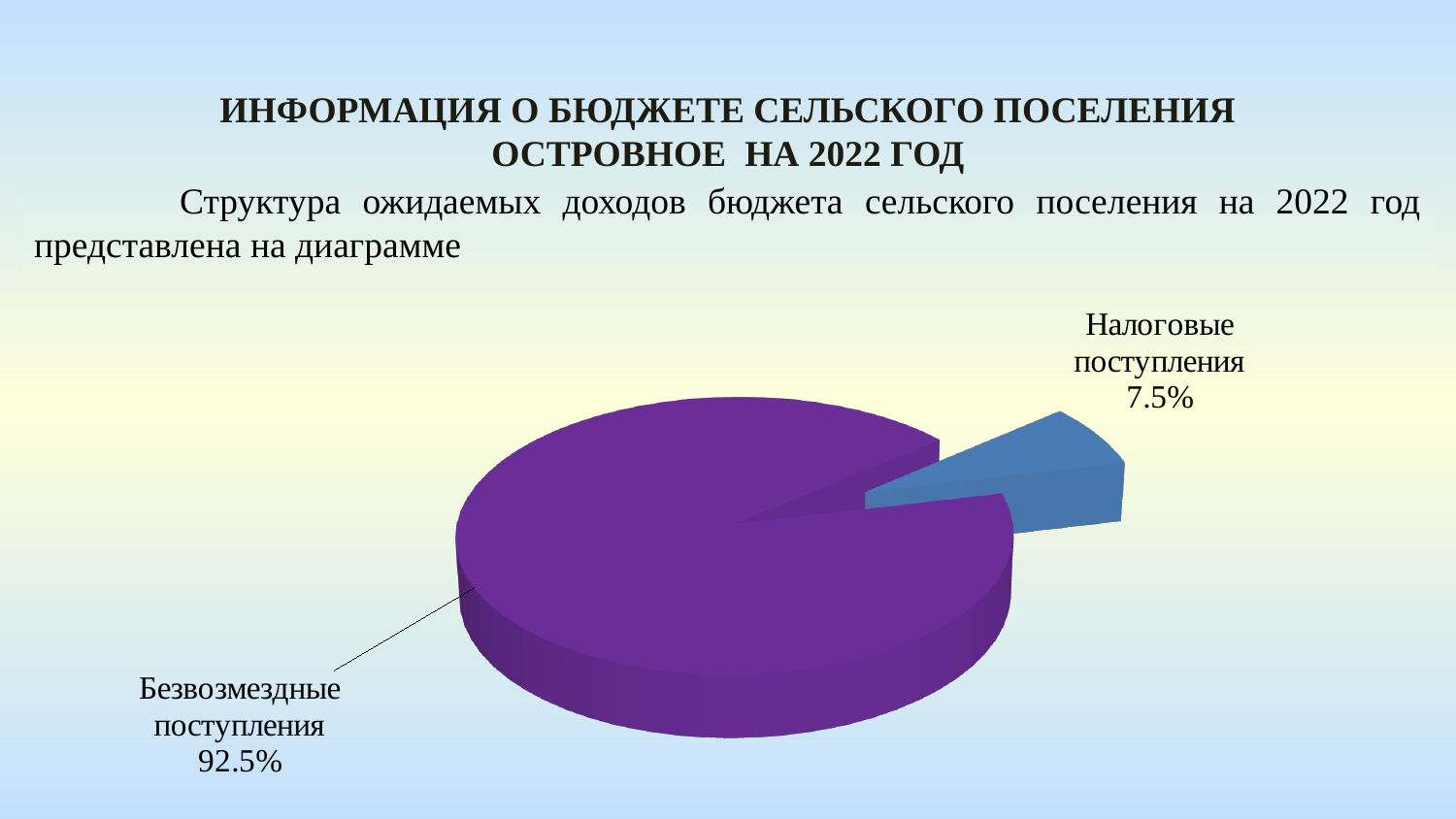
Which slice of the pie is the largest? Безвозмездные поступления What share of the pie is labelled "Безвозмездные поступления"? 92.5% Which slice of the pie is the smallest? Налоговые поступления Which is larger: "Налоговые поступления" or "Безвозмездные поступления"? Безвозмездные поступления What colour is the slice for "Налоговые поступления"? Blue What kind of chart is shown on the slide? Pie chart How many slices does the pie chart have? 2 Is the share for "Налоговые поступления" greater or less than 10%? less What colour is the slice for "Безвозмездные поступления"? Purple What share of the pie is labelled "Налоговые поступления"? 7.5% Is the share for "Безвозмездные поступления" greater or less than 90%? greater What is the difference in percentage points between "Безвозмездные поступления" and "Налоговые поступления"? 85 percentage points